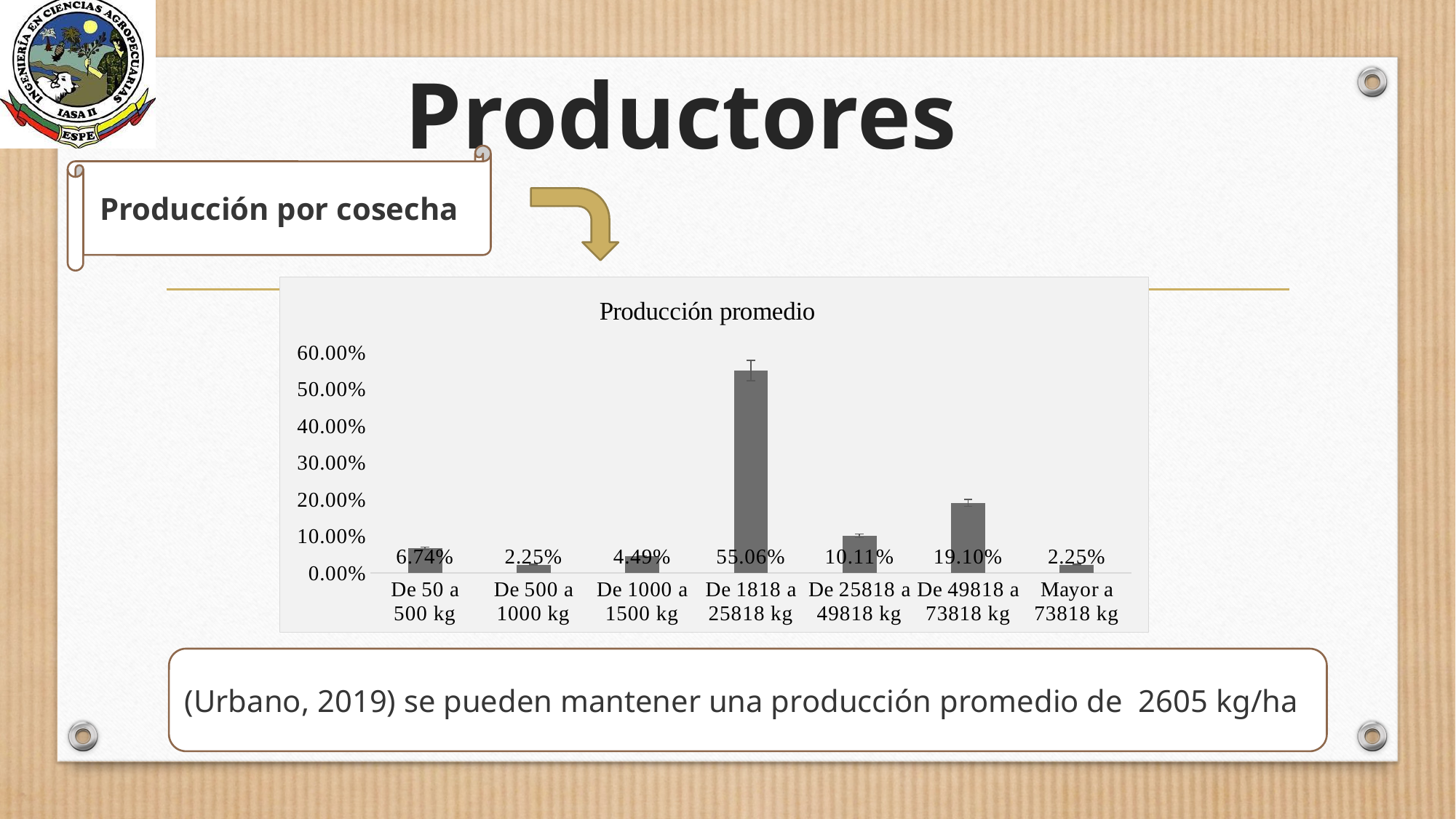
What is the value for the 'Mayor a 73818 kg' category? 2.25% What is the value for the 'De 49818 a 73818 kg' category? 19.10% What is the difference between the values for 'De 49818 a 73818 kg' and 'De 25818 a 49818 kg'? 8.99% What is the difference between the values for 'De 1818 a 25818 kg' and 'De 49818 a 73818 kg'? 35.96% Is the value for 'De 1818 a 25818 kg' greater or less than 50%? greater How many categories are shown on the x axis? 7 Which category has the highest value? De 1818 a 25818 kg What is the value for the 'De 1818 a 25818 kg' category? 55.06% What kind of chart is shown on the slide? bar chart Which is larger, the value for 'De 50 a 500 kg' or the value for 'De 1000 a 1500 kg'? De 50 a 500 kg What is the title of the chart? Producción promedio What is the value for the 'De 50 a 500 kg' category? 6.74%